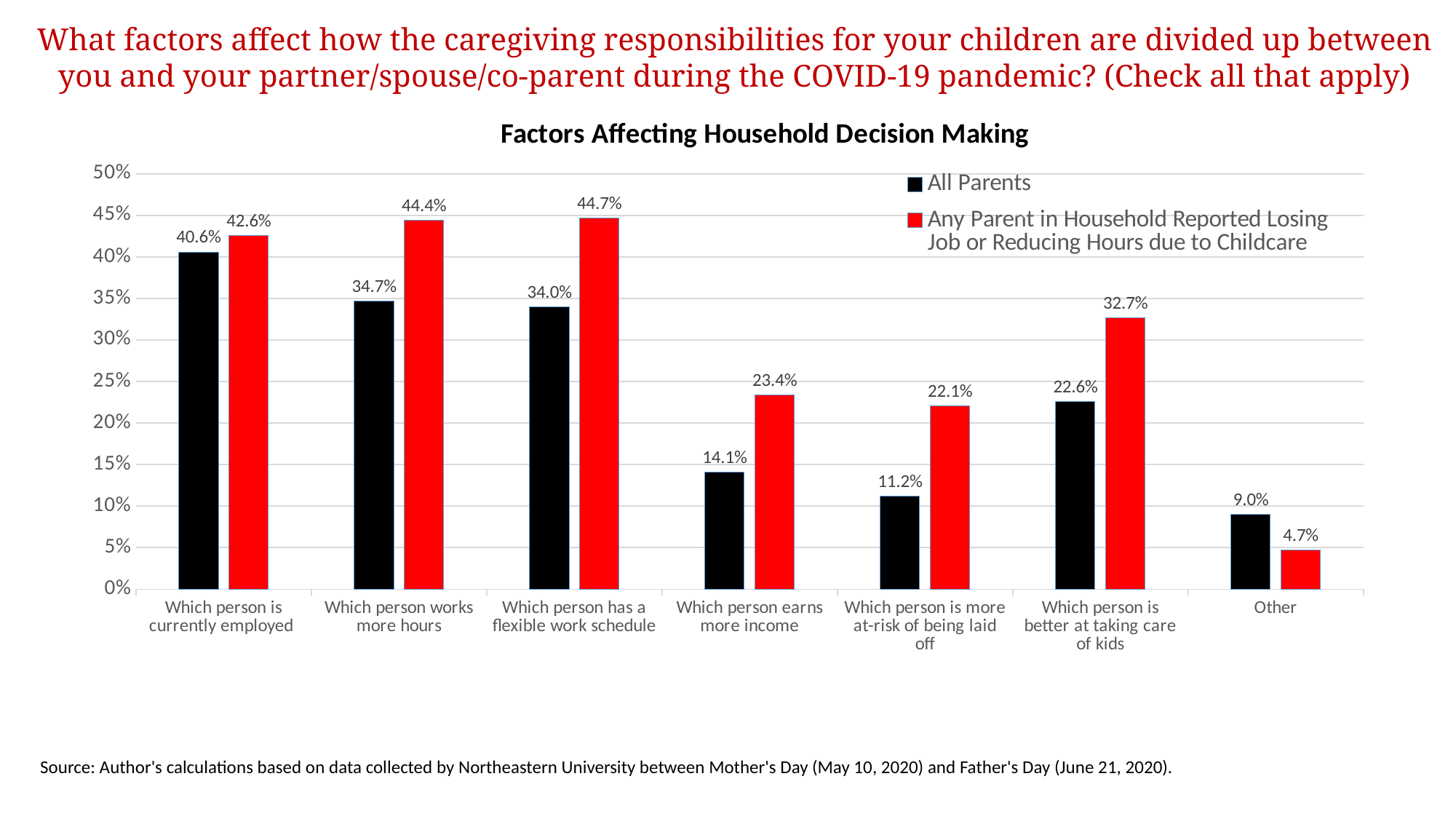
Is the All Parents value for "Which person is more at-risk of being laid off" greater or less than 15%? less What is the value for "Other" in the All Parents series? 9.0% What is the difference between the two series for "Which person is better at taking care of kids"? 10.1% Which category has the lowest value in the Any Parent in Household Reported Losing Job or Reducing Hours due to Childcare series? Other How many series does the legend list? 2 What is the value for "Which person is currently employed" in the All Parents series? 40.6% What is the value for "Which person has a flexible work schedule" in the Any Parent in Household Reported Losing Job or Reducing Hours due to Childcare series? 44.7% What is the title of the chart? Factors Affecting Household Decision Making For "Which person earns more income", which series has the larger value? Any Parent in Household Reported Losing Job or Reducing Hours due to Childcare What kind of chart is shown on the slide? bar chart How many categories are shown on the x axis? 7 Which category has the highest value in the All Parents series? Which person is currently employed